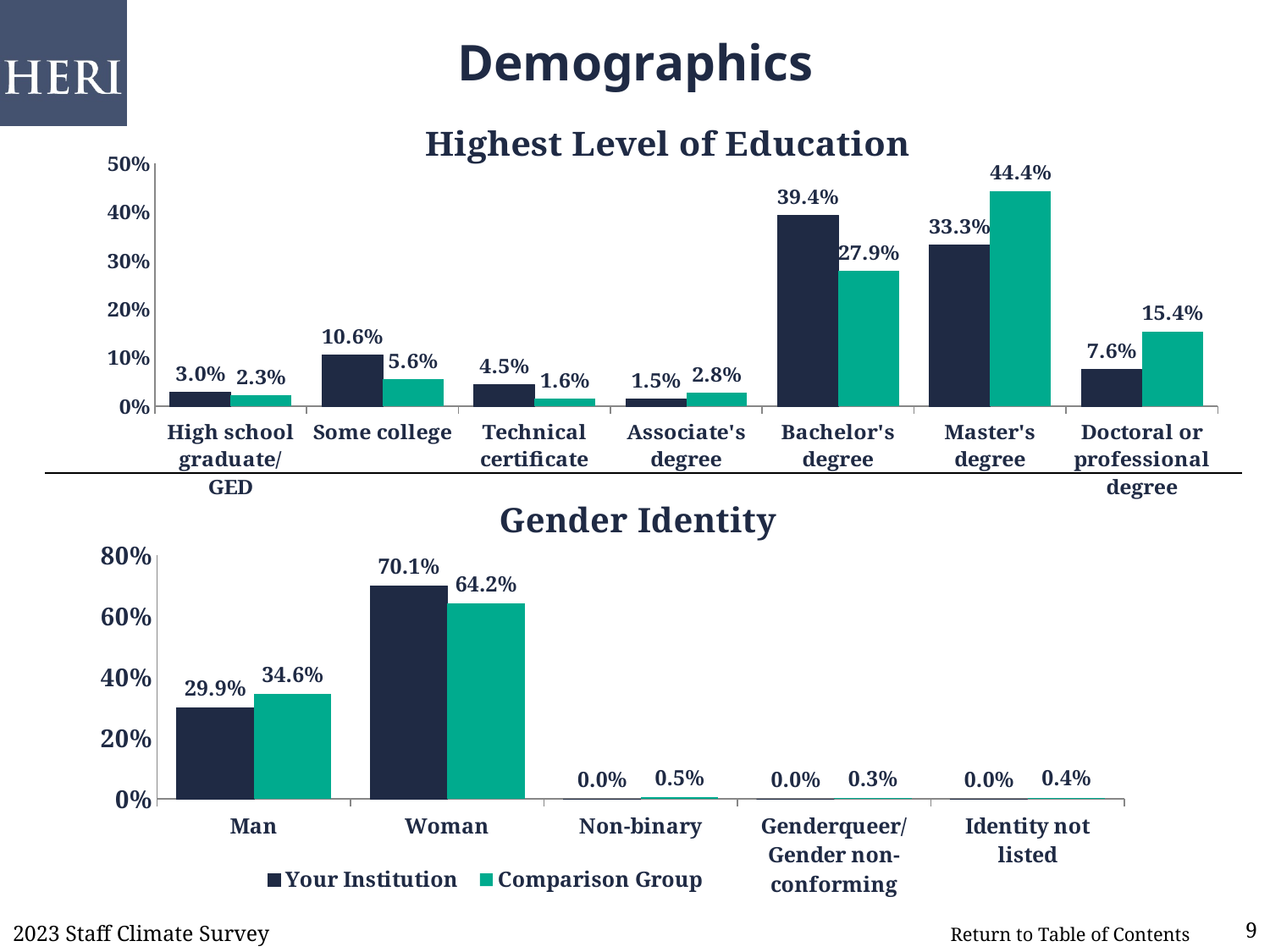
In the Highest Level of Education chart, which category has the highest Comparison Group value? Master's degree In the Highest Level of Education chart, what is the Comparison Group value for Doctoral or professional degree? 15.4% In the Highest Level of Education chart, which is larger for Some college: Your Institution or Comparison Group? Your Institution In the Highest Level of Education chart, which category has the lowest Your Institution value? Associate's degree In the Gender Identity chart, what is the difference between the Comparison Group and Your Institution values for Man? 4.7% What type of chart is the Gender Identity chart? Bar chart How many categories are shown in the Highest Level of Education chart? 7 How many series does the legend list for the Gender Identity chart? 2 In the Gender Identity chart, what is the Comparison Group value for Non-binary? 0.5% In the Highest Level of Education chart, what is the value for Your Institution for Bachelor's degree? 39.4% In the Highest Level of Education chart, what is the difference between Your Institution and Comparison Group for Bachelor's degree? 11.5% In the Gender Identity chart, what is the Your Institution value for Woman? 70.1%